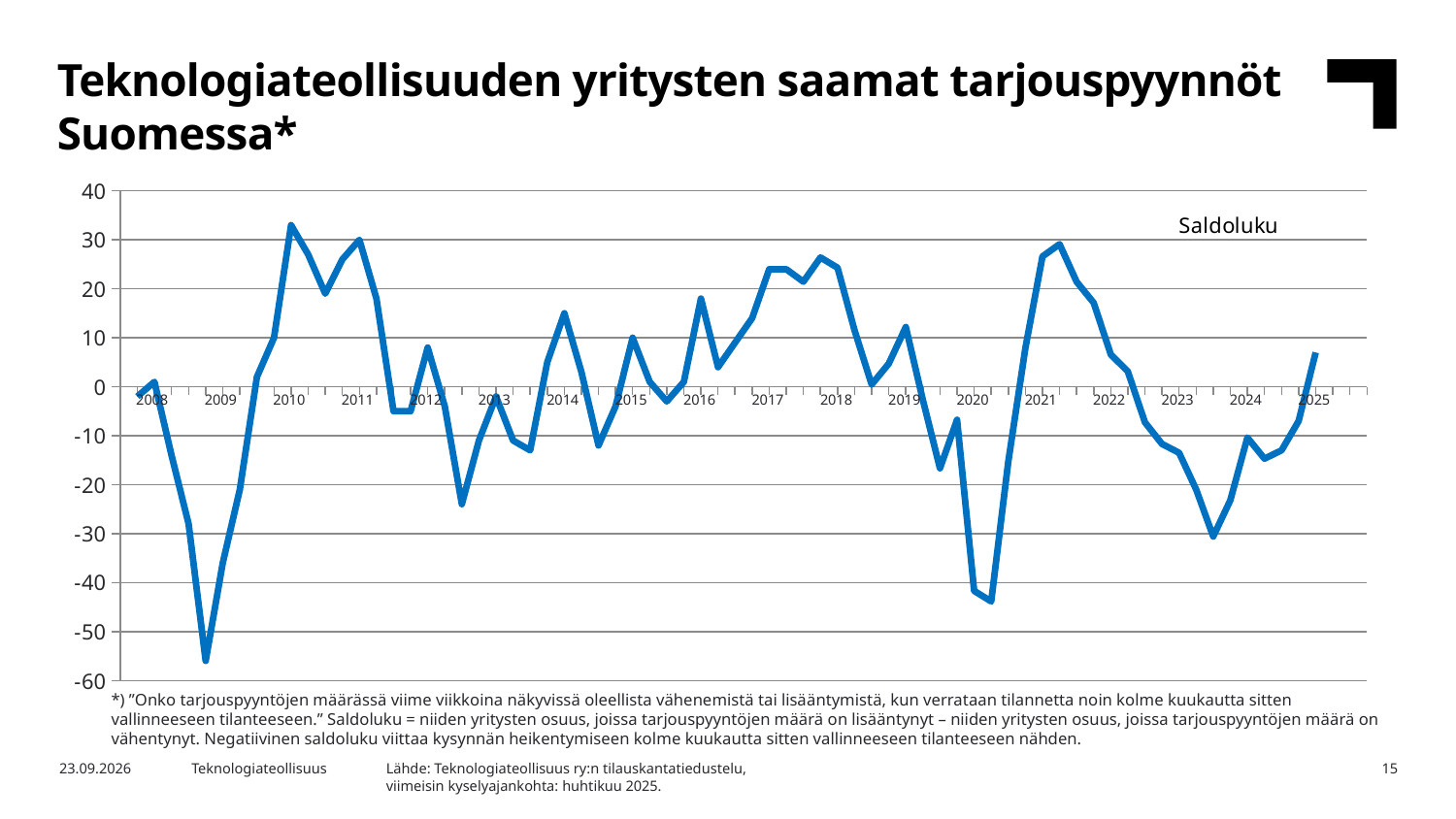
Is the low point of the line in 2020 greater or less than -40? less Do the values rise or fall from the 2021 peak to the 2023 low? fall In which year does the line reach its lowest value? 2009 Is the lowest value of the line, in 2009, greater or less than -50? less How many series does the chart plot? 1 What is the title of the chart on the slide? Teknologiateollisuuden yritysten saamat tarjouspyynnöt Suomessa* Is the peak value of the line in 2010 greater or less than 30? greater Which low point is lower: the one in 2009 or the one in 2020? 2009 What is the name of the series plotted in the chart? Saldoluku What kind of chart is shown on the slide? line chart